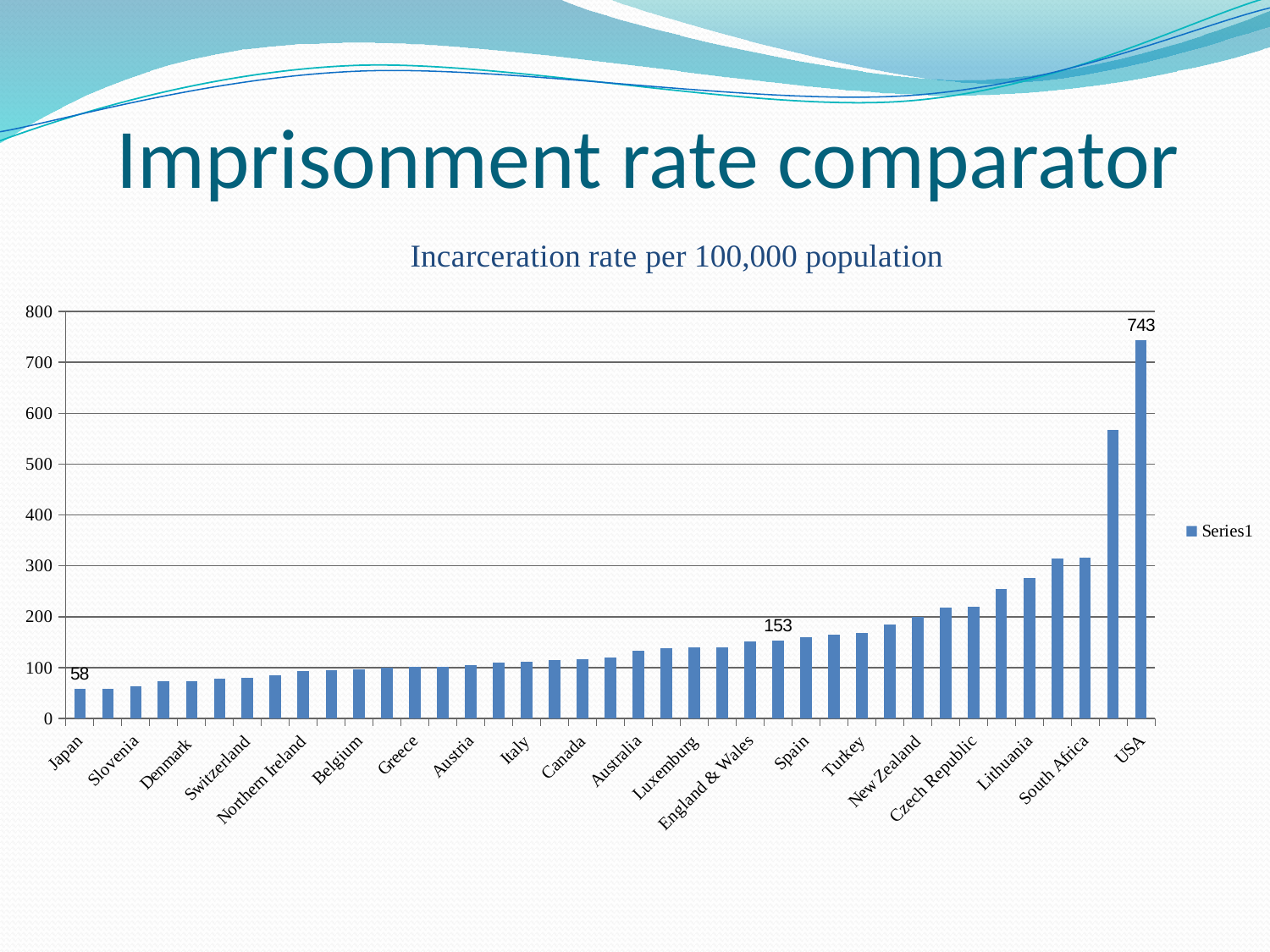
Is the value for Turkey greater or less than 200? less Which has a higher incarceration rate, Denmark or Czech Republic? Czech Republic What is the title of the chart? Incarceration rate per 100,000 population Which has a higher incarceration rate, South Africa or the USA? USA Which country has the highest incarceration rate? USA What is the difference between the incarceration rates of the USA and Japan? 685 What kind of chart is shown on the slide? Bar chart What is the incarceration rate for Japan? 58 Is the value for Lithuania greater or less than 200? greater Do the values rise or fall moving from left to right along the x axis? Rise Is the value for South Africa greater or less than 300? greater What is the incarceration rate for the USA? 743